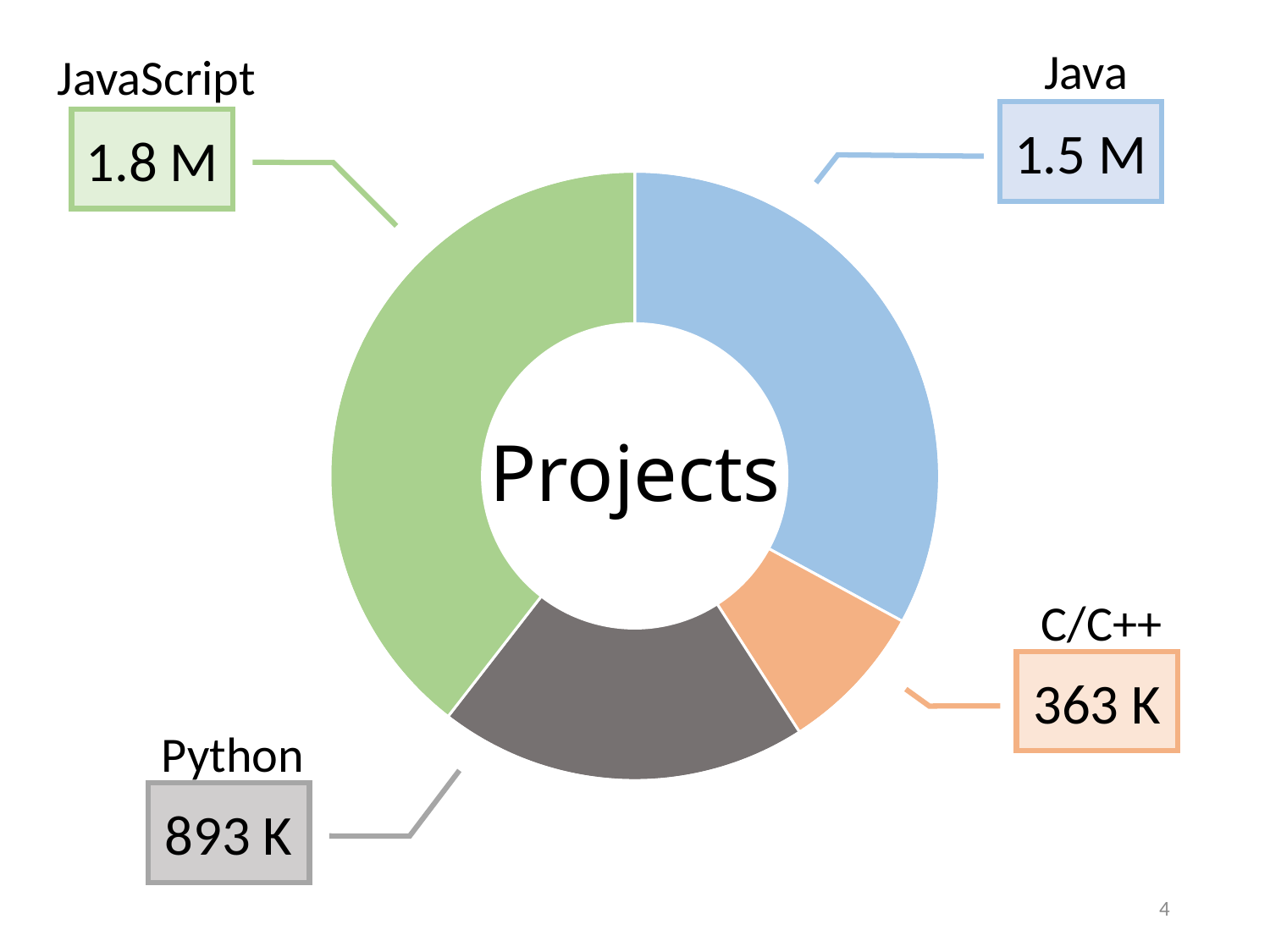
What is the difference between the JavaScript and Java values? 0.3 M What is the value shown for JavaScript? 1.8 M Which has more projects, Python or C/C++? Python What is the value shown for C/C++? 363 K What kind of chart is shown on the slide? doughnut chart How many languages are shown in the chart? 4 What is the difference between the Python and C/C++ values? 530 K Which language has the smallest number of projects? C/C++ What is the value shown for Python? 893 K What is the value shown for Java? 1.5 M Which has more projects, Java or Python? Java Which language has the largest number of projects? JavaScript